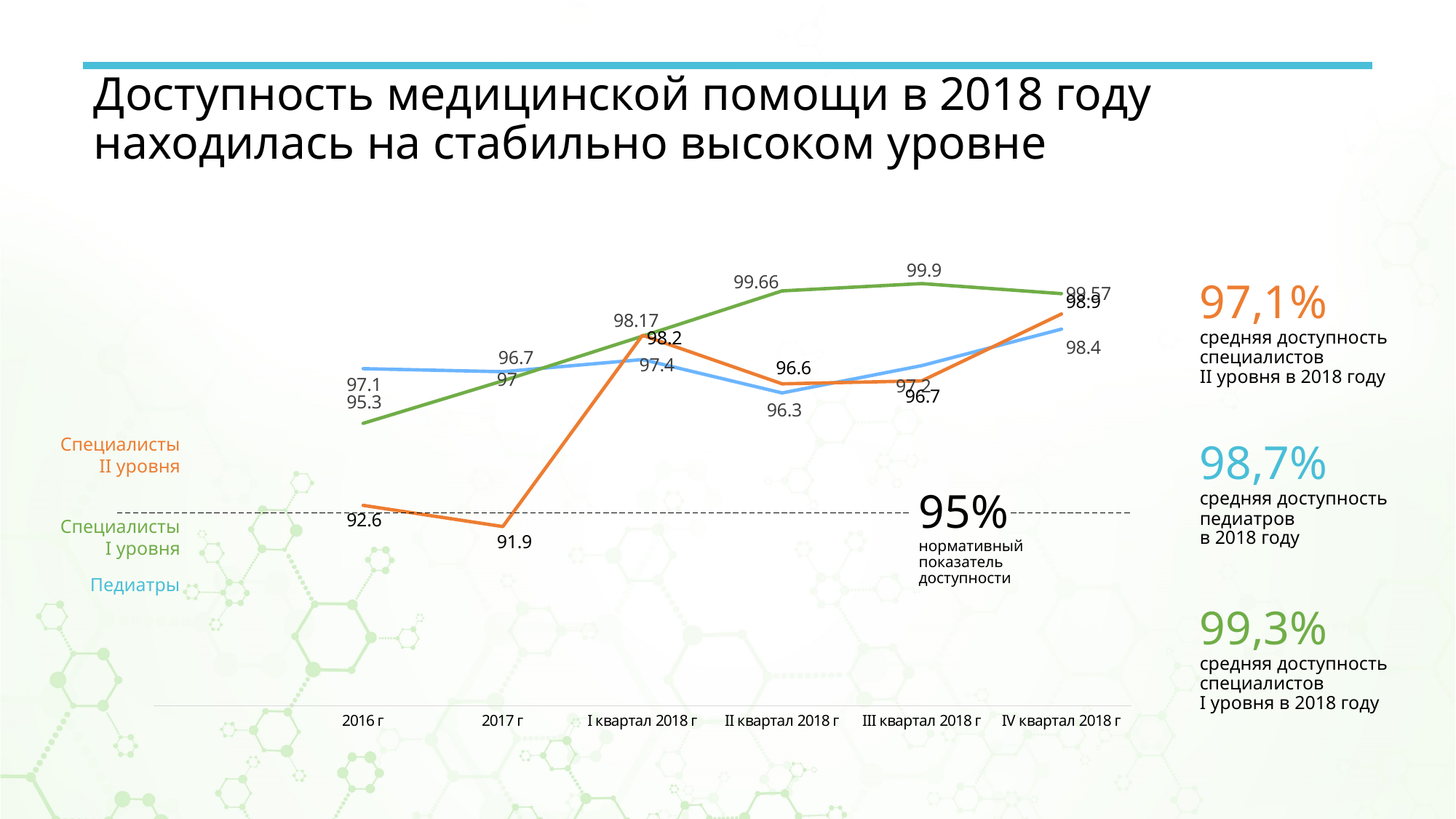
At which time point is the Специалисты II уровня line at its lowest? 2017 г What is the value for Специалисты I уровня in 2016 г? 95.3 What value does the dashed horizontal line (нормативный показатель доступности) mark? 95% What is the value for Специалисты II уровня in 2017 г? 91.9 What kind of chart is shown on the slide? Line chart How many series (lines) does the chart show? 3 In 2016 г, which is higher: Педиатры or Специалисты I уровня? Педиатры By how much did the value for Специалисты II уровня increase from 2017 г to I квартал 2018 г? 6.3 At which time point does the Специалисты I уровня line reach its highest value? III квартал 2018 г Is the value for Специалисты II уровня in 2017 г greater or less than 95? less What is the value for Педиатры in II квартал 2018 г? 96.3 How many time points are shown along the x axis of the chart? 6